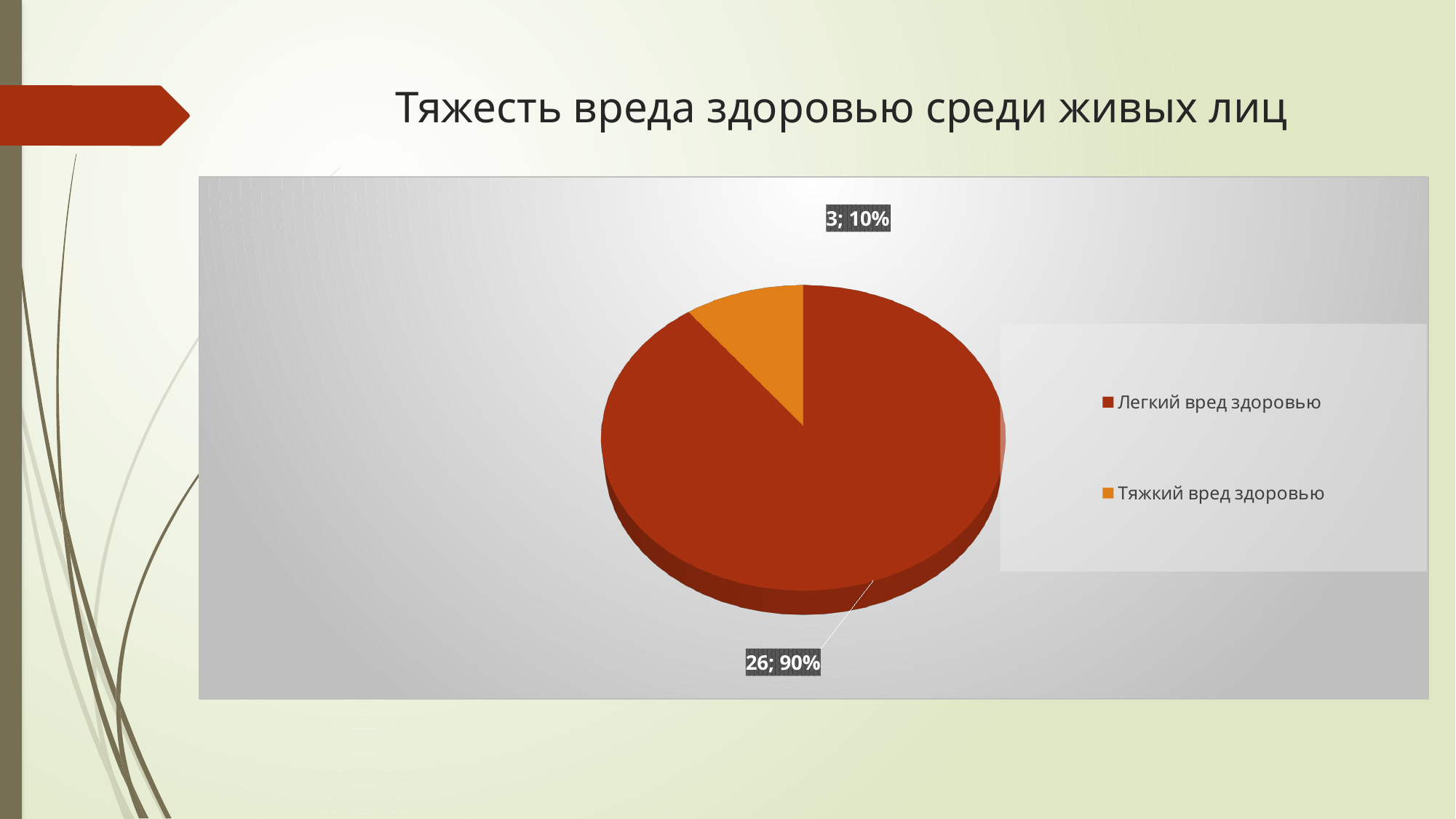
Which is larger, the value for Легкий вред здоровью or Тяжкий вред здоровью? Легкий вред здоровью What is the difference between the values for Легкий вред здоровью and Тяжкий вред здоровью? 23 What share of the pie does Легкий вред здоровью take? 90% Which category has the smallest slice? Тяжкий вред здоровью What is the title of the chart on the slide? Тяжесть вреда здоровью среди живых лиц How many slices does the pie chart have? 2 What colour is the slice for Тяжкий вред здоровью? orange What is the value for Легкий вред здоровью? 26 What share of the pie does Тяжкий вред здоровью take? 10% What is the value for Тяжкий вред здоровью? 3 What kind of chart is shown on the slide? pie chart Which category has the largest slice? Легкий вред здоровью